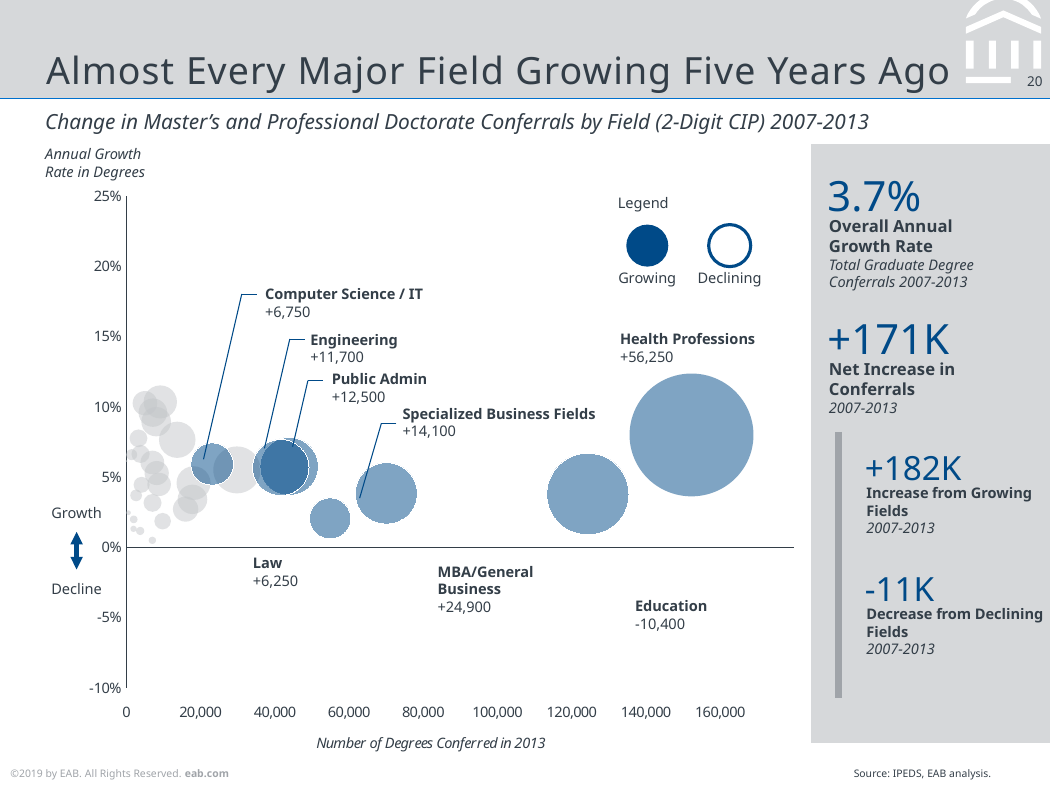
What is the change in conferrals shown for MBA/General Business? +24,900 What is the change in conferrals shown for Health Professions? +56,250 Which has the larger change in conferrals, Engineering or Public Admin? Public Admin How many entries does the chart legend list? 2 Which labeled field has the largest change in conferrals? Health Professions What is the difference between the change in conferrals for Health Professions and for MBA/General Business? 31,350 What kind of chart is shown on the slide? Bubble chart How many fields are labeled on the chart? 8 What is the change in conferrals shown for Computer Science / IT? +6,750 Which labeled field has the smallest change in conferrals? Education Is the number of degrees conferred in 2013 for Health Professions greater or less than 140,000? greater What is the change in conferrals shown for Education? -10,400